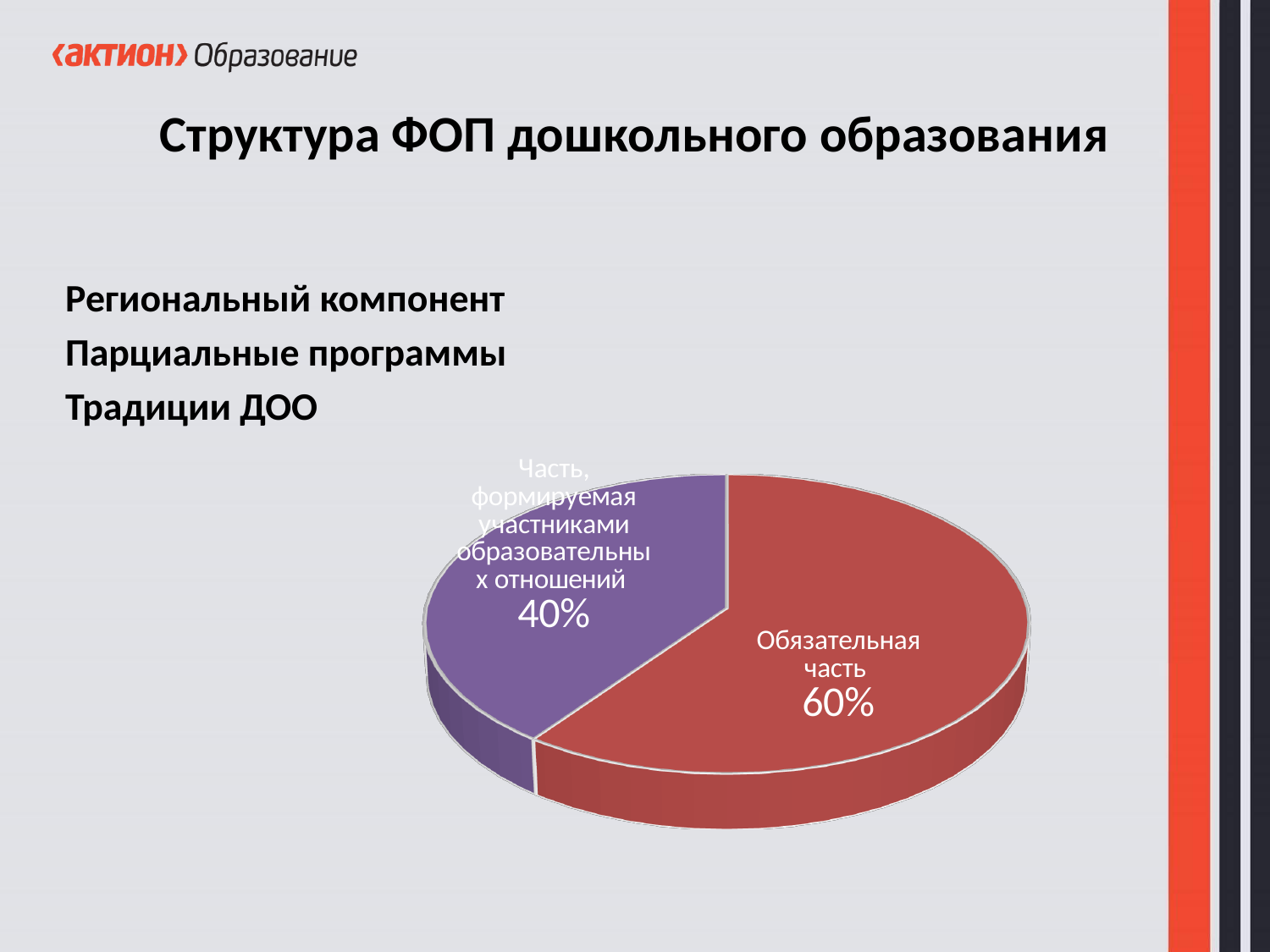
Which slice of the pie is the smallest? Часть, формируемая участниками образовательных отношений What is the difference in percentage points between "Обязательная часть" and "Часть, формируемая участниками образовательных отношений"? 20 percentage points Which is larger: "Обязательная часть" or "Часть, формируемая участниками образовательных отношений"? Обязательная часть Which slice of the pie is the largest? Обязательная часть What share of the pie does "Обязательная часть" take? 60% What kind of chart is shown on the slide? Pie chart What share of the pie does "Часть, формируемая участниками образовательных отношений" take? 40% How many slices does the pie chart have? 2 Is the share for "Обязательная часть" greater or less than 50%? greater What colour is the "Обязательная часть" slice? Red What colour is the "Часть, формируемая участниками образовательных отношений" slice? Purple